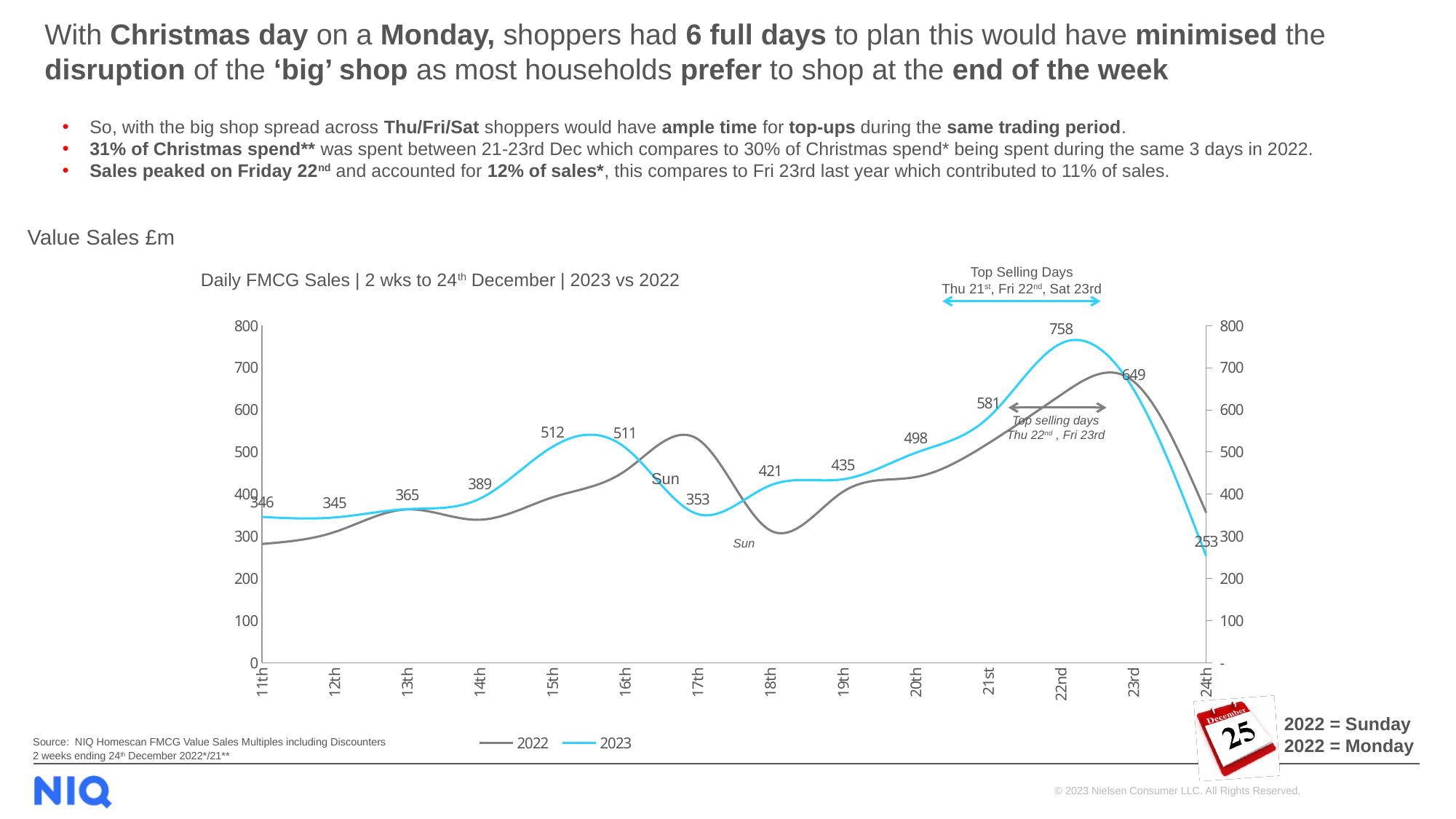
On the 22nd, which series has the higher value, 2022 or 2023? 2023 On which date does the 2023 line reach its lowest value? 24th What is the difference between the 2023 values for the 22nd and the 23rd? 109 How many series does the chart legend list? 2 What kind of chart is shown on the slide? line chart How many dates are shown on the x axis? 14 Is the 2022 value for the 18th greater or less than 400? less What is the 2023 value sales figure for the 22nd? 758 What is the 2023 value sales figure for the 17th? 353 What is the 2023 value sales figure for the 24th? 253 What is the difference between the 2023 values for the 21st and the 20th? 83 On which date does the 2023 line reach its highest value? 22nd